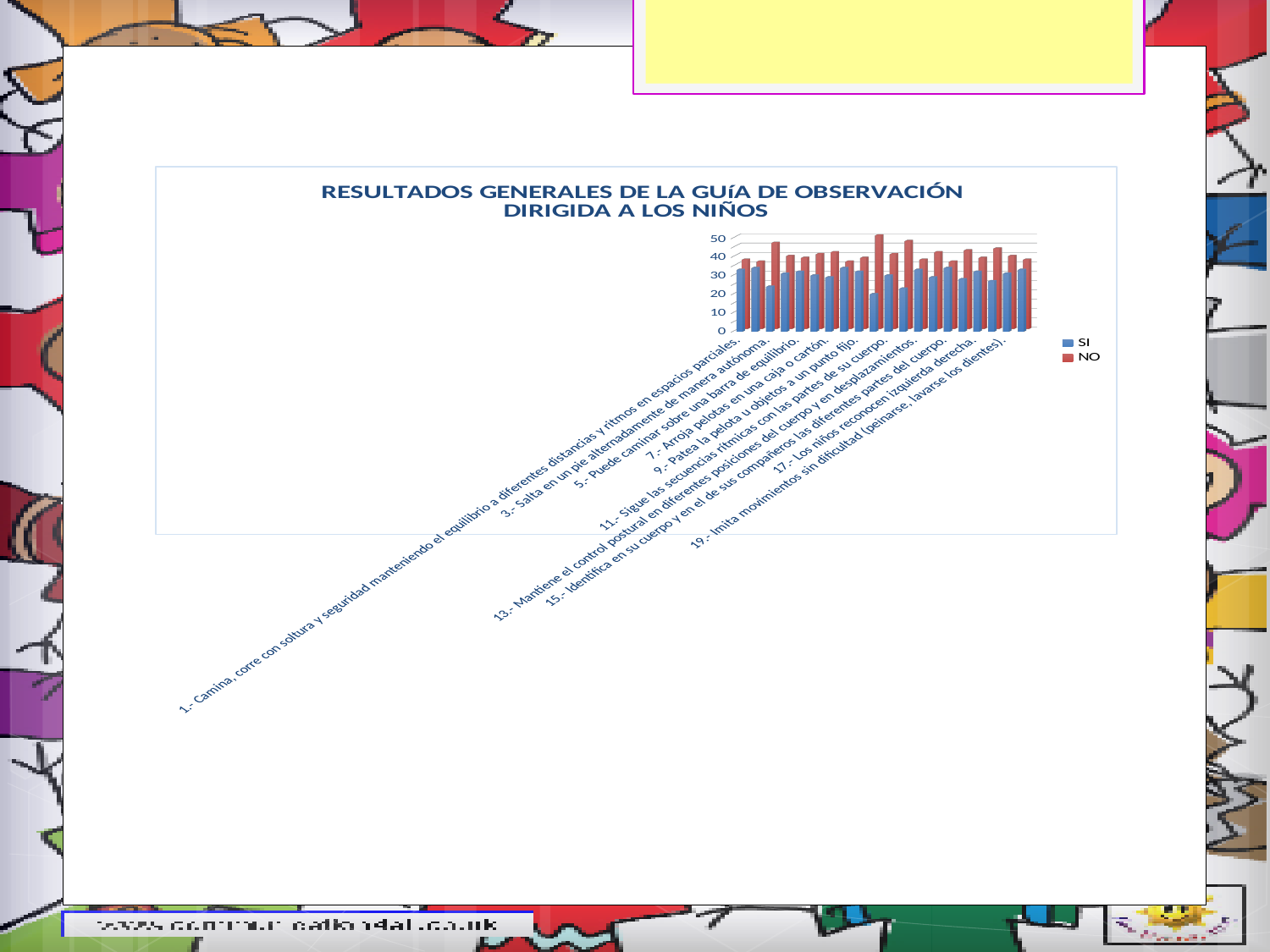
Is the SI value for '3.- Salta en un pie alternadamente de manera autónoma.' greater or less than 40? less What is the highest value shown on the vertical axis? 50 How many series does the legend list? 2 What are the two series named in the legend? SI and NO For the category '3.- Salta en un pie alternadamente de manera autónoma.', which series has the larger value, SI or NO? NO Is the NO value for '3.- Salta en un pie alternadamente de manera autónoma.' greater or less than 30? greater Which series has the taller bar in every category of the chart? NO What kind of chart is shown on the slide? bar chart Which series is shown in red? NO Is the SI value for '1.- Camina, corre con soltura y seguridad manteniendo el equilibrio a diferentes distancias y ritmos en espacios parciales.' greater or less than 50? less